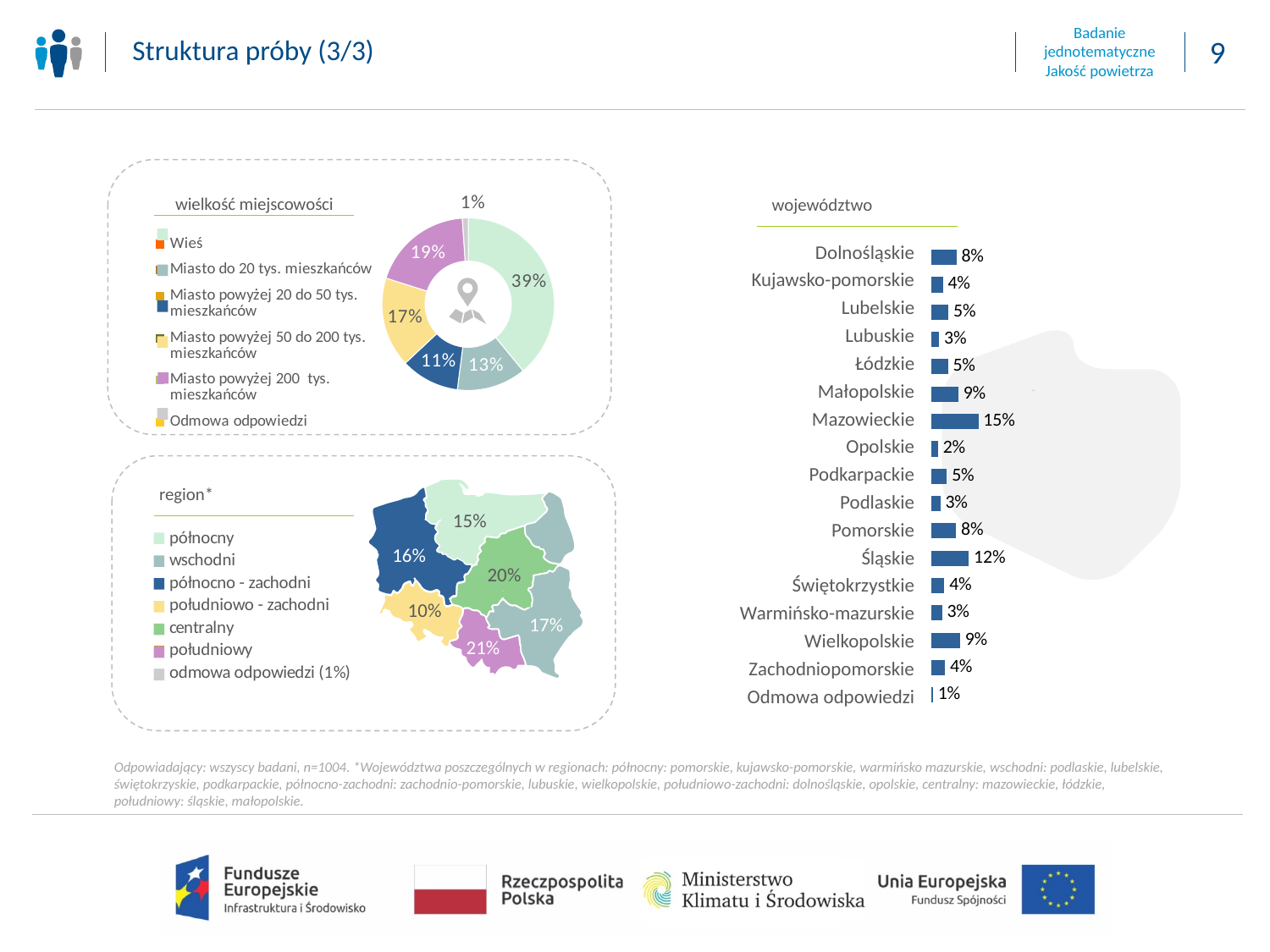
In the 'region*' map chart, which region has the highest value? południowy In the 'wielkość miejscowości' donut chart, what share is shown for 'Wieś'? 39% In the 'wielkość miejscowości' donut chart, what is the difference between the shares for 'Miasto powyżej 200 tys. mieszkańców' and 'Miasto powyżej 20 do 50 tys. mieszkańców'? 8% In the 'województwo' bar chart, what is the difference between the values for Śląskie and Dolnośląskie? 4% In the 'województwo' bar chart, which voivodeship has the highest value? Mazowieckie In the 'województwo' bar chart, which voivodeship has the lowest value (excluding 'Odmowa odpowiedzi')? Opolskie In the 'województwo' bar chart, which is larger: the value for Małopolskie or the value for Pomorskie? Małopolskie In the 'region*' map chart, what is the value for the 'centralny' region? 20% How many categories are shown in the 'województwo' bar chart? 17 In the 'wielkość miejscowości' donut chart, which category has the smallest share? Odmowa odpowiedzi What type of chart is the 'województwo' chart? Bar chart In the 'województwo' bar chart, what is the value for Mazowieckie? 15%